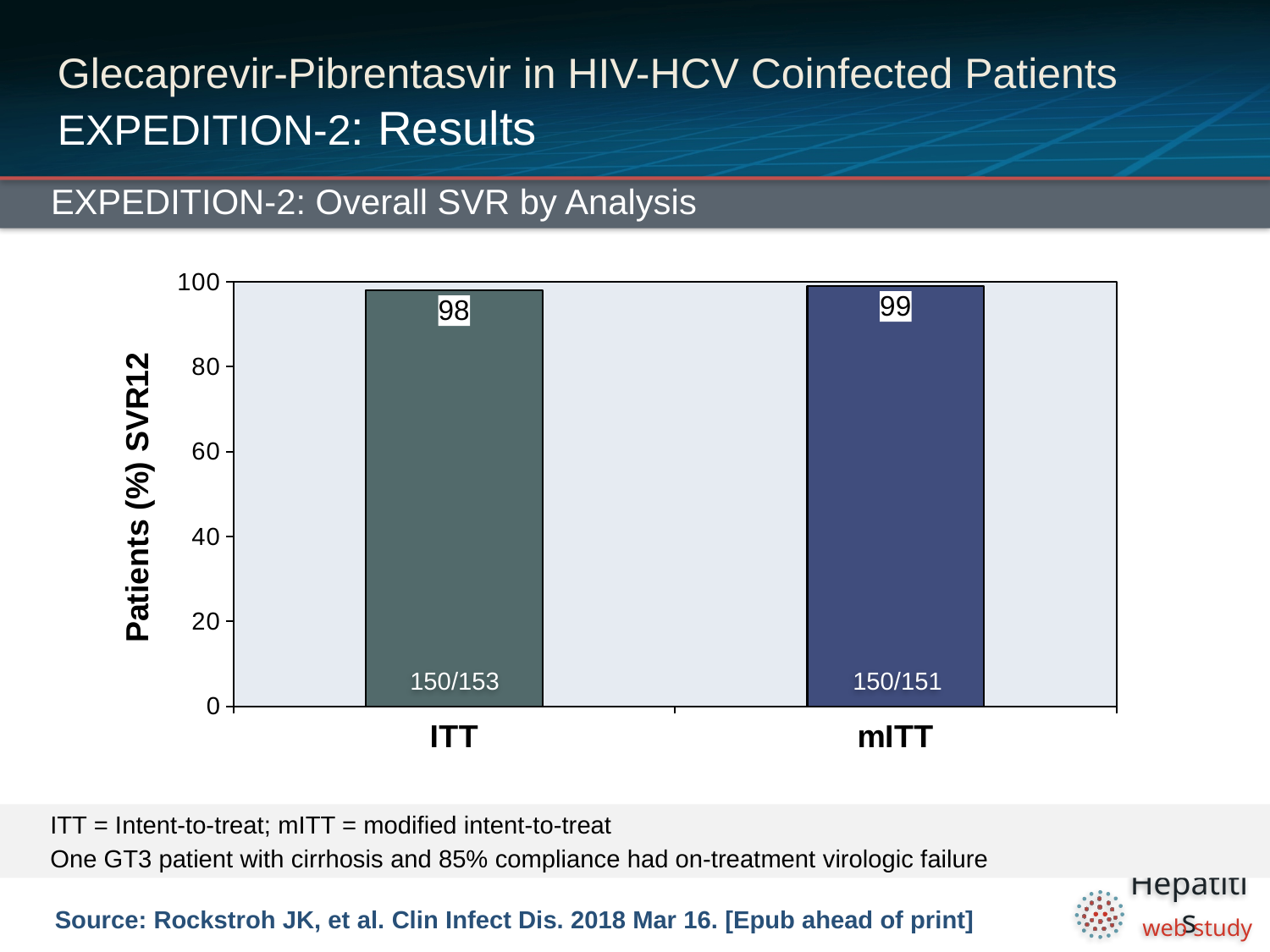
What is the title of the chart? EXPEDITION-2: Overall SVR by Analysis What fraction of patients is shown inside the ITT bar? 150/153 What is the maximum value shown on the y axis? 100 What is the SVR12 value for the mITT analysis? 99 How many categories are shown on the x axis? 2 Is the value for ITT greater or less than 80? greater What is the difference between the mITT and ITT SVR12 values? 1 What is the label of the y axis? Patients (%) SVR12 What fraction of patients is shown inside the mITT bar? 150/151 What is the SVR12 value for the ITT analysis? 98 What kind of chart is shown on the slide? bar chart Which analysis has the higher SVR12 value, ITT or mITT? mITT